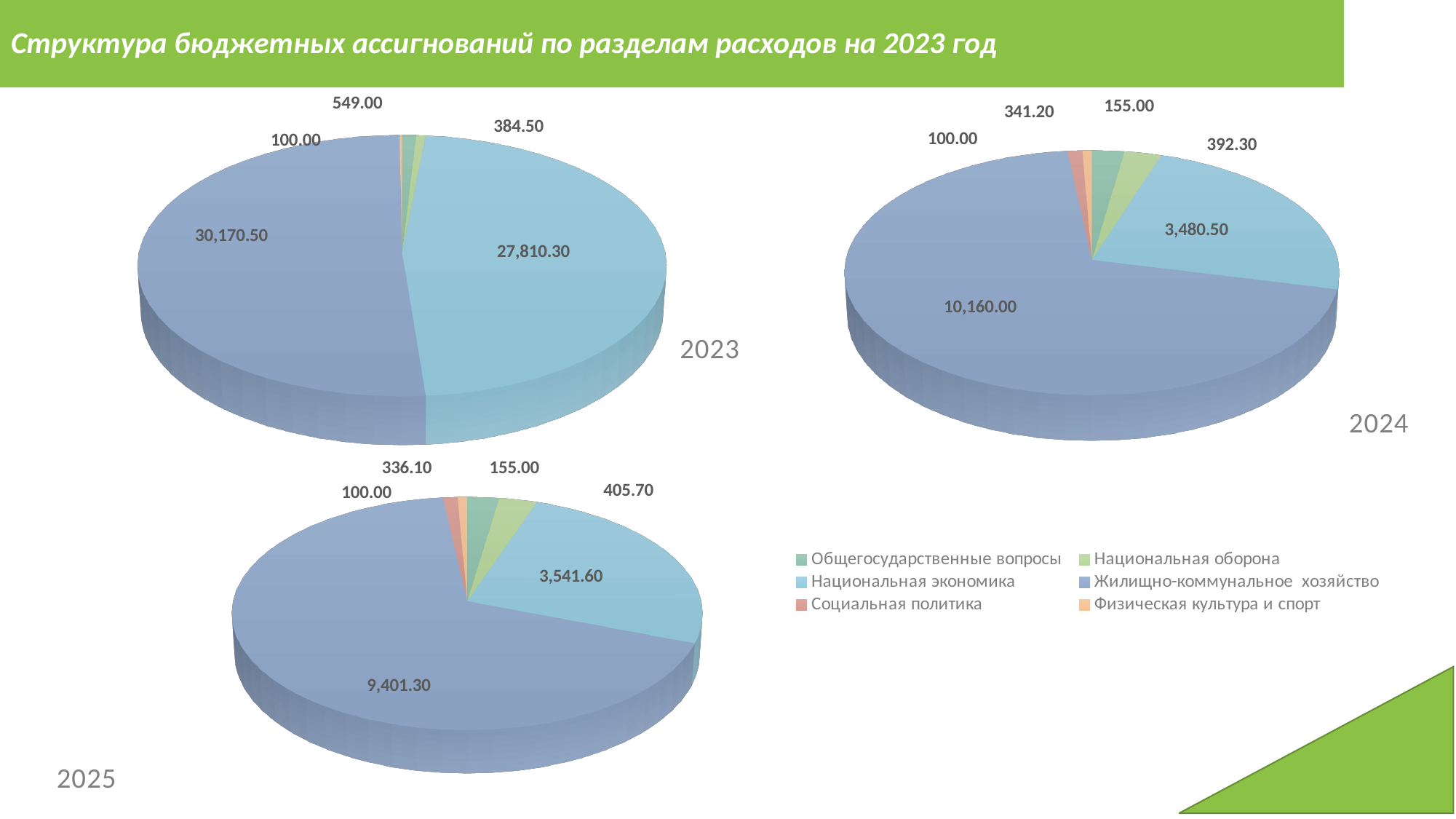
In the 2023 pie chart, what is the value for Национальная экономика? 27,810.30 In the 2023 pie chart, what is the difference between Жилищно-коммунальное хозяйство and Национальная экономика? 2,360.20 In the 2023 pie chart, what is the value for Жилищно-коммунальное хозяйство? 30,170.50 In the 2025 pie chart, what is the value for Жилищно-коммунальное хозяйство? 9,401.30 In the 2024 pie chart, what is the value for Жилищно-коммунальное хозяйство? 10,160.00 In the 2025 pie chart, which category has the largest slice? Жилищно-коммунальное хозяйство What kind of charts are shown on the slide? Pie charts How many pie charts are shown on the slide? 3 In the 2024 pie chart, what is the value for Национальная экономика? 3,480.50 In the 2024 pie chart, which is larger: Жилищно-коммунальное хозяйство or Национальная экономика? Жилищно-коммунальное хозяйство How many series does the legend list? 6 In the 2025 pie chart, what is the value for Национальная экономика? 3,541.60